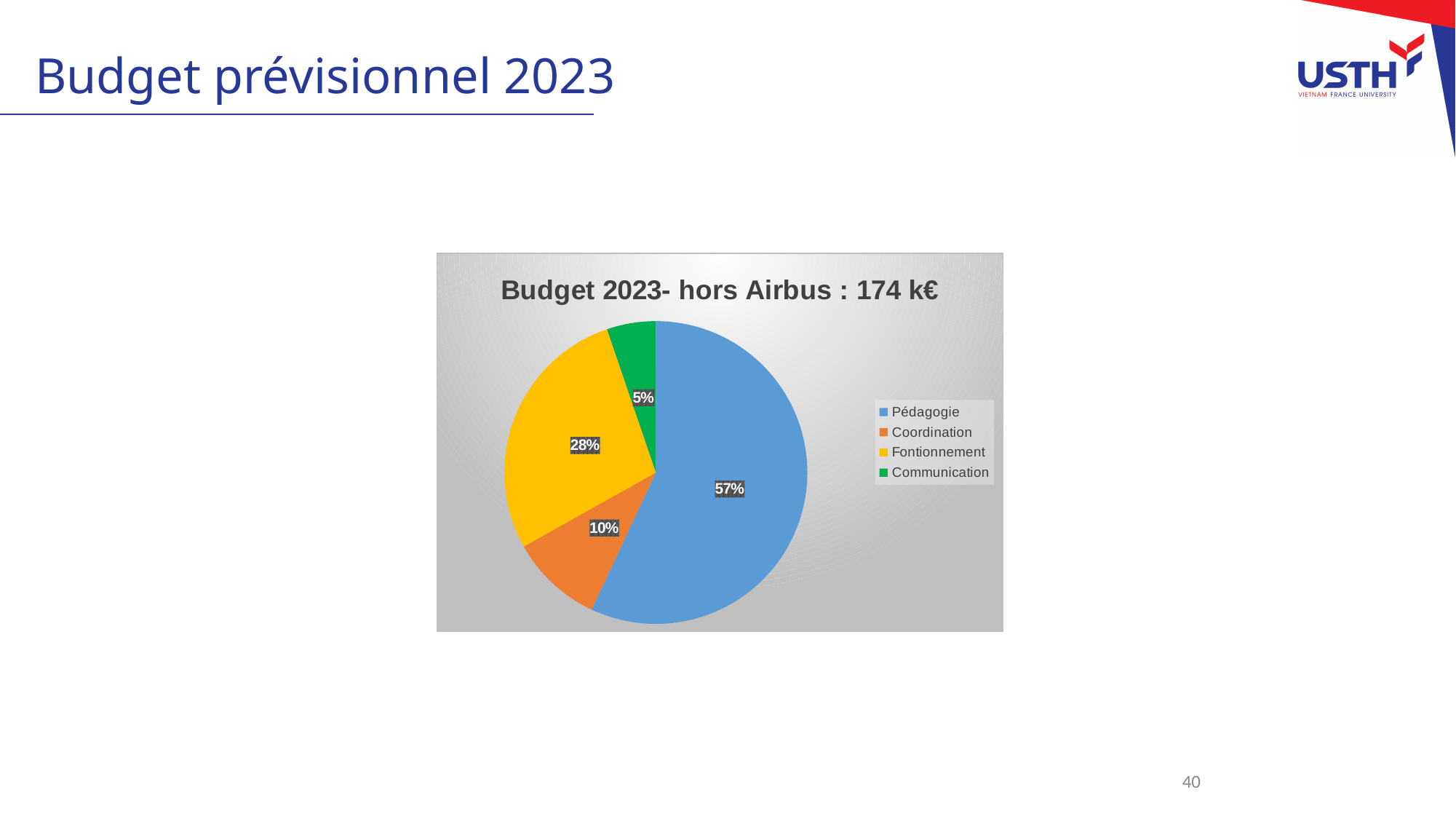
What is the difference in percentage points between the Pédagogie and Fontionnement shares? 29 What kind of chart is shown on the slide? pie chart What share of the budget goes to Coordination? 10% Which has a larger share, Coordination or Fontionnement? Fontionnement What colour is the Communication slice? green What share of the budget goes to Pédagogie? 57% Which category has the largest share of the budget? Pédagogie How many categories does the pie chart show? 4 Which category has the smallest share of the budget? Communication What share of the budget goes to Communication? 5% What is the title of the chart? Budget 2023- hors Airbus : 174 k€